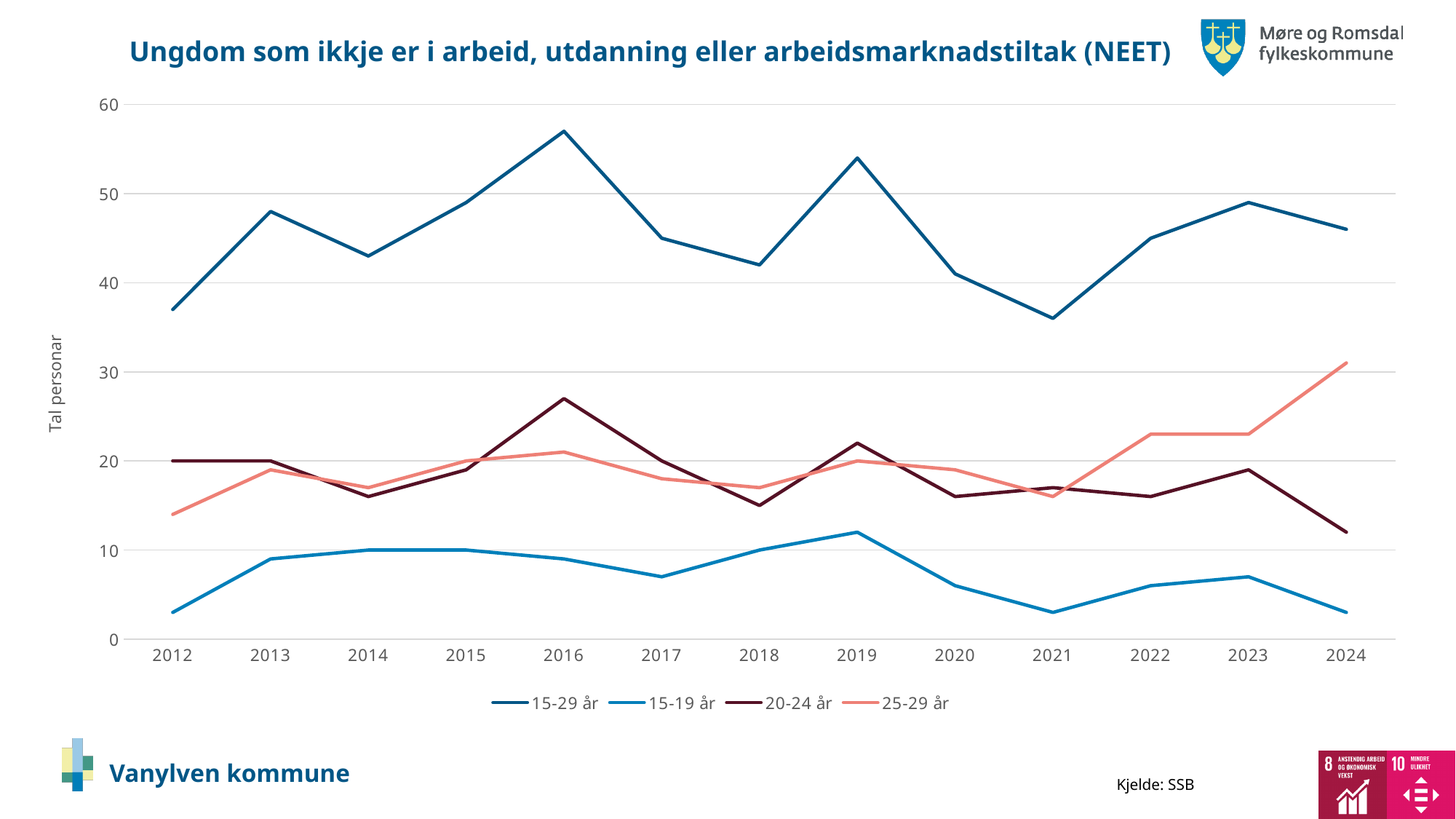
Is the value for 15-29 år in 2021 greater or less than 40? less Is the value for 15-29 år in 2016 greater or less than 50? greater Does the 25-29 år series rise or fall from 2021 to 2024? rise Is the value for 15-19 år in 2021 greater or less than 10? less In which year does the 15-29 år series reach its highest value? 2016 What is the label on the y axis? Tal personar In 2024, which series has the larger value: 25-29 år or 20-24 år? 25-29 år How many years are shown on the x axis? 13 In which year does the 25-29 år series reach its highest value? 2024 How many series does the legend list? 4 In which year does the 20-24 år series reach its highest value? 2016 What kind of chart is shown on the slide? line chart